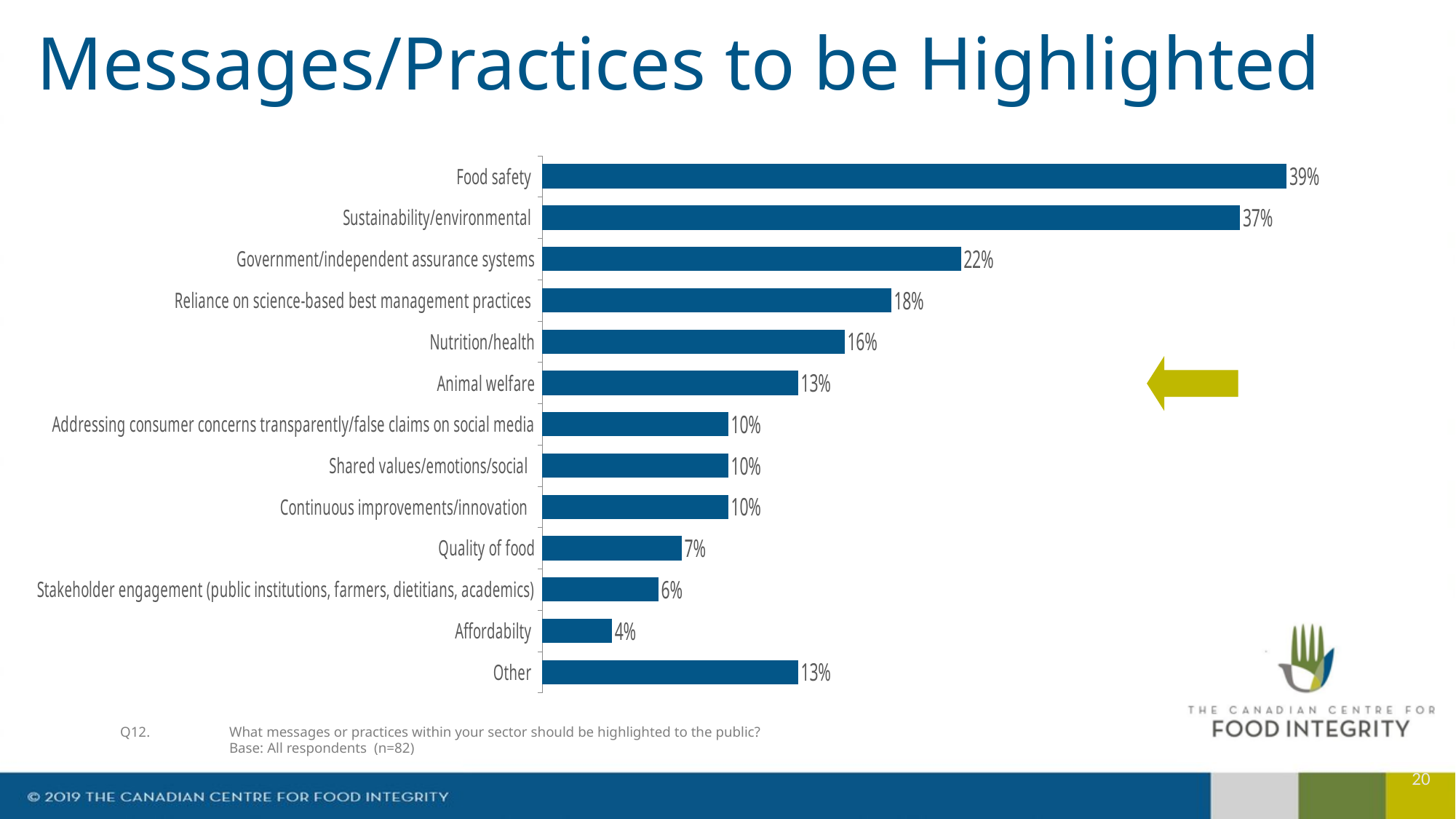
Which category has the lowest value? Affordabilty Which category has the highest value? Food safety What is the difference between Food safety and Sustainability/environmental? 2% What is the value for Government/independent assurance systems? 22% What is the value for Animal welfare? 13% What percentage of respondents said Food safety should be highlighted? 39% What kind of chart is shown on the slide? Bar chart What is the value for Affordabilty? 4% Which is larger, Reliance on science-based best management practices or Nutrition/health? Reliance on science-based best management practices How many categories are shown in the chart? 13 What is the base size (n) stated below the chart? n=82 What is the difference between Nutrition/health and Quality of food? 9%